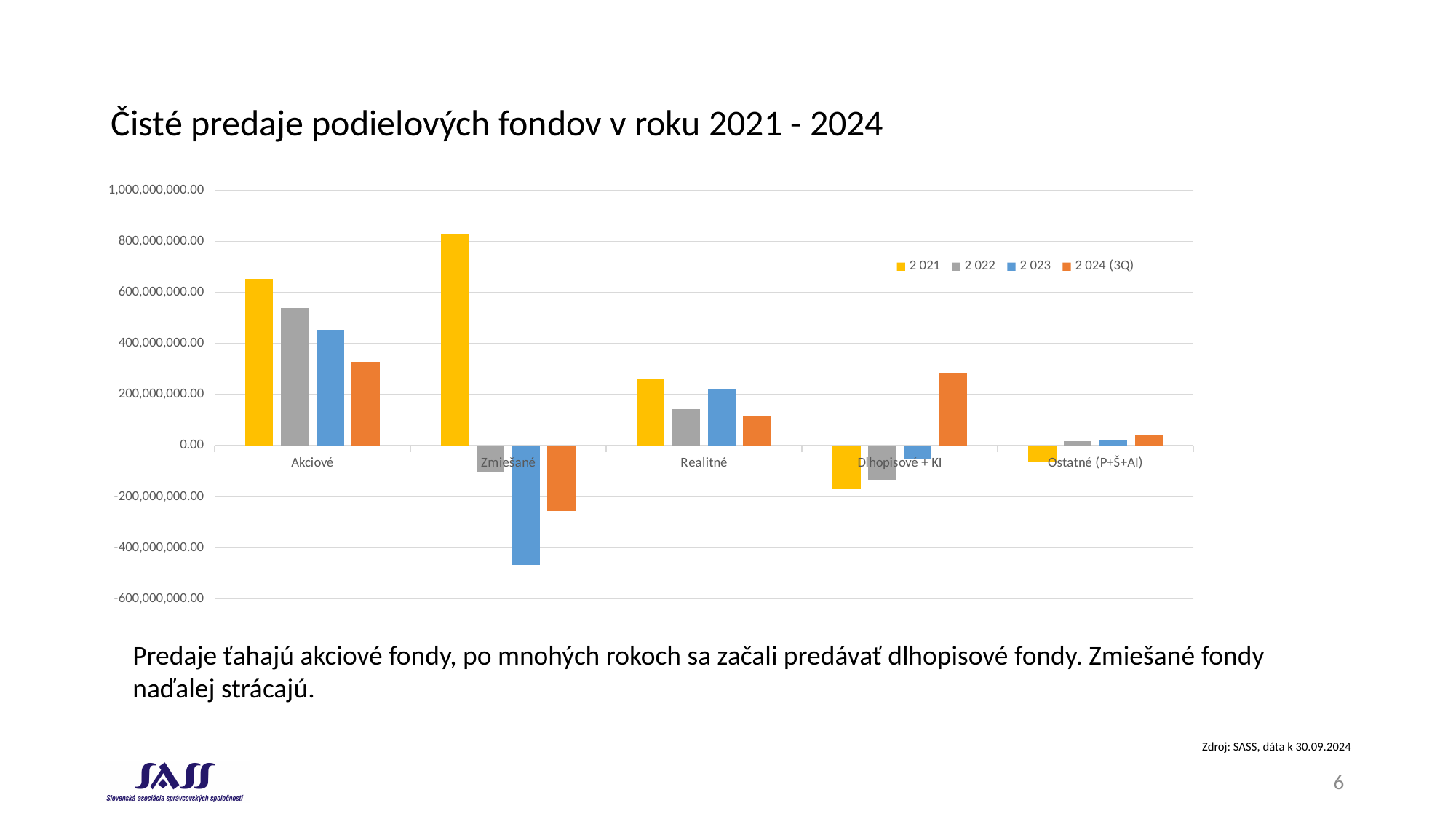
How many series does the legend list? 4 Which is larger: the 2 024 (3Q) value for Dlhopisové + KI or the 2 024 (3Q) value for Realitné? Dlhopisové + KI What is the title of the chart? Čisté predaje podielových fondov v roku 2021 - 2024 For Akciové, which series has the larger value: 2 022 or 2 023? 2 022 How many fund categories are shown on the x axis? 5 Is the 2 021 value for Akciové greater or less than 600,000,000.00? greater Is the 2 023 value for Zmiešané greater or less than -400,000,000.00? less Which category has the lowest value for the 2 023 series? Zmiešané What kind of chart is shown on the slide? bar chart Is the 2 024 (3Q) value for Dlhopisové + KI greater or less than 200,000,000.00? greater Which category has the highest value for the 2 021 series? Zmiešané For Akciové, do the values rise or fall from the 2 021 series to the 2 024 (3Q) series? fall